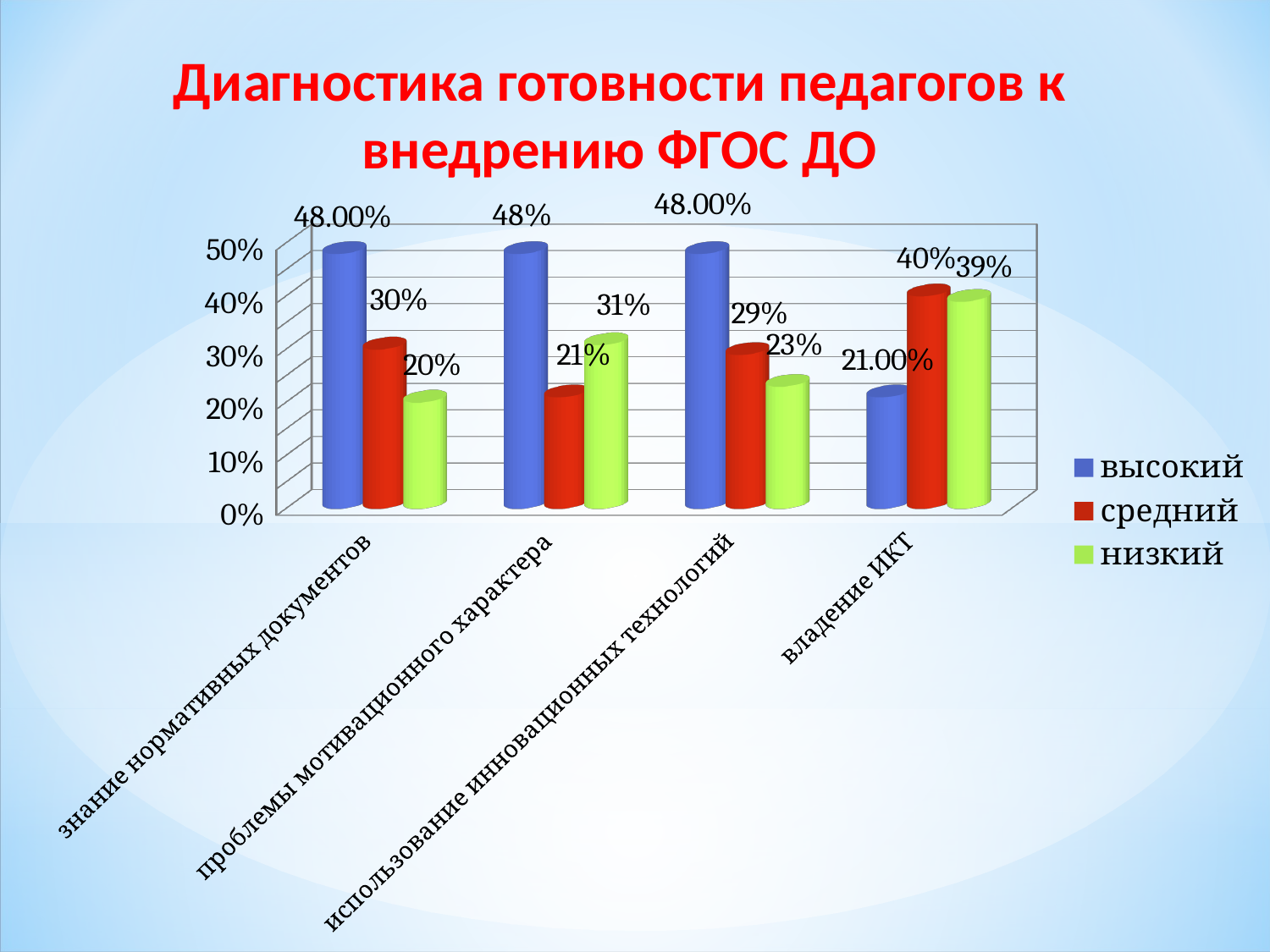
In the category проблемы мотивационного характера, which is larger: средний or низкий? низкий How many categories are shown on the x axis? 4 What is the value for высокий in the category знание нормативных документов? 48.00% What kind of chart is shown on the slide? bar chart Which category has the highest value for средний? владение ИКТ Which category has the lowest value for высокий? владение ИКТ What is the value for низкий in the category использование инновационных технологий? 23% What is the value for высокий in the category владение ИКТ? 21.00% Which series is shown in red in the legend? средний What is the difference between the средний and низкий values in the category знание нормативных документов? 10% How many series does the legend list? 3 What is the value for средний in the category проблемы мотивационного характера? 21%